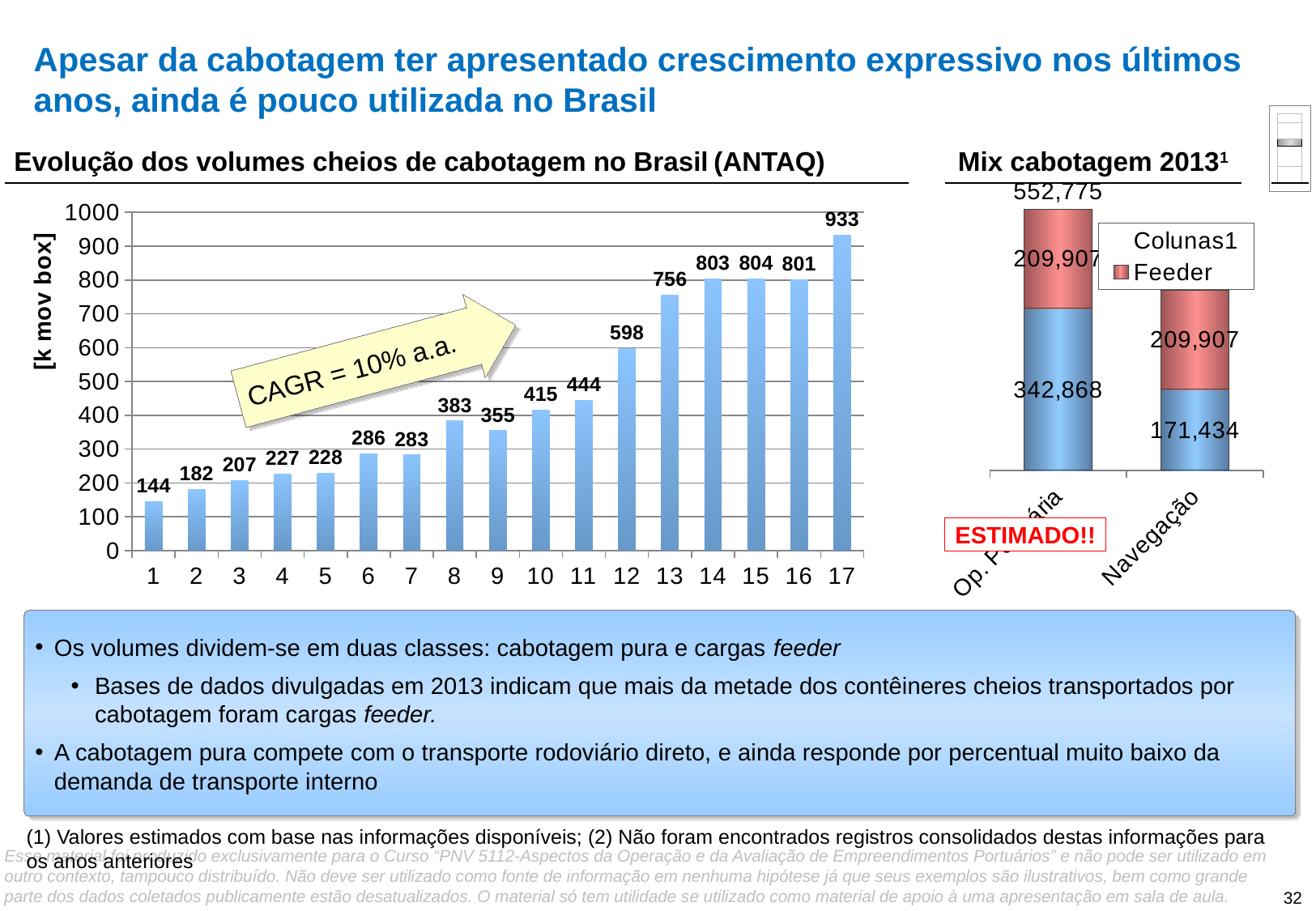
In the chart 'Mix cabotagem 2013', what is the total of the stacked bar for Op. Portuária? 552,775 In the chart 'Evolução dos volumes cheios de cabotagem no Brasil (ANTAQ)', which is larger, the value for category 8 or category 9? Category 8 What type of chart is 'Evolução dos volumes cheios de cabotagem no Brasil (ANTAQ)'? Bar chart In the chart 'Mix cabotagem 2013', what is the Feeder value for Navegação? 209,907 In the chart 'Evolução dos volumes cheios de cabotagem no Brasil (ANTAQ)', do the values generally rise or fall from category 1 to category 17? Rise How many categories are shown on the x axis of the chart 'Evolução dos volumes cheios de cabotagem no Brasil (ANTAQ)'? 17 What is the y-axis unit label on the chart 'Evolução dos volumes cheios de cabotagem no Brasil (ANTAQ)'? [k mov box] In the chart 'Evolução dos volumes cheios de cabotagem no Brasil (ANTAQ)', which category has the highest value? 17 In the chart 'Evolução dos volumes cheios de cabotagem no Brasil (ANTAQ)', what is the difference between the values for category 17 and category 1? 789 In the chart 'Evolução dos volumes cheios de cabotagem no Brasil (ANTAQ)', which category has the lowest value? 1 In the chart 'Evolução dos volumes cheios de cabotagem no Brasil (ANTAQ)', what is the value for category 17? 933 In the chart 'Evolução dos volumes cheios de cabotagem no Brasil (ANTAQ)', what is the value for category 12? 598